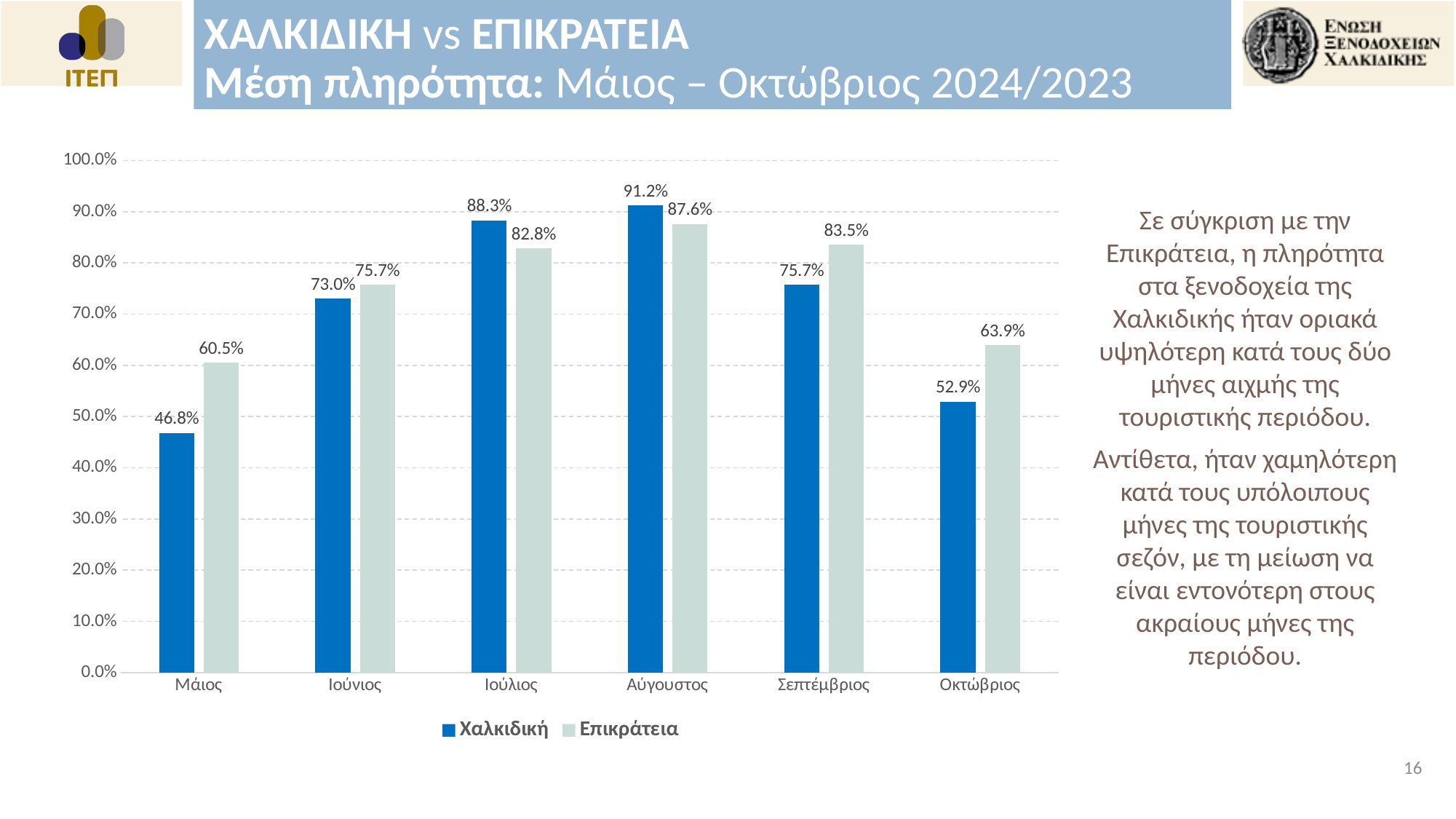
Which month has the highest value for Χαλκιδική? Αύγουστος What is the value for Επικράτεια in Οκτώβριος? 63.9% How many months are shown on the x axis? 6 What is the value for Χαλκιδική in Μάιος? 46.8% What is the difference between Επικράτεια and Χαλκιδική in Μάιος? 13.7% Which month has the lowest value for Επικράτεια? Μάιος Which is larger in Ιούλιος, Χαλκιδική or Επικράτεια? Χαλκιδική What kind of chart is shown on the slide? bar chart Which series is shown in dark blue? Χαλκιδική How many series does the legend list? 2 What is the value for Επικράτεια in Αύγουστος? 87.6% Is the value for Χαλκιδική in Σεπτέμβριος greater or less than 80.0%? less